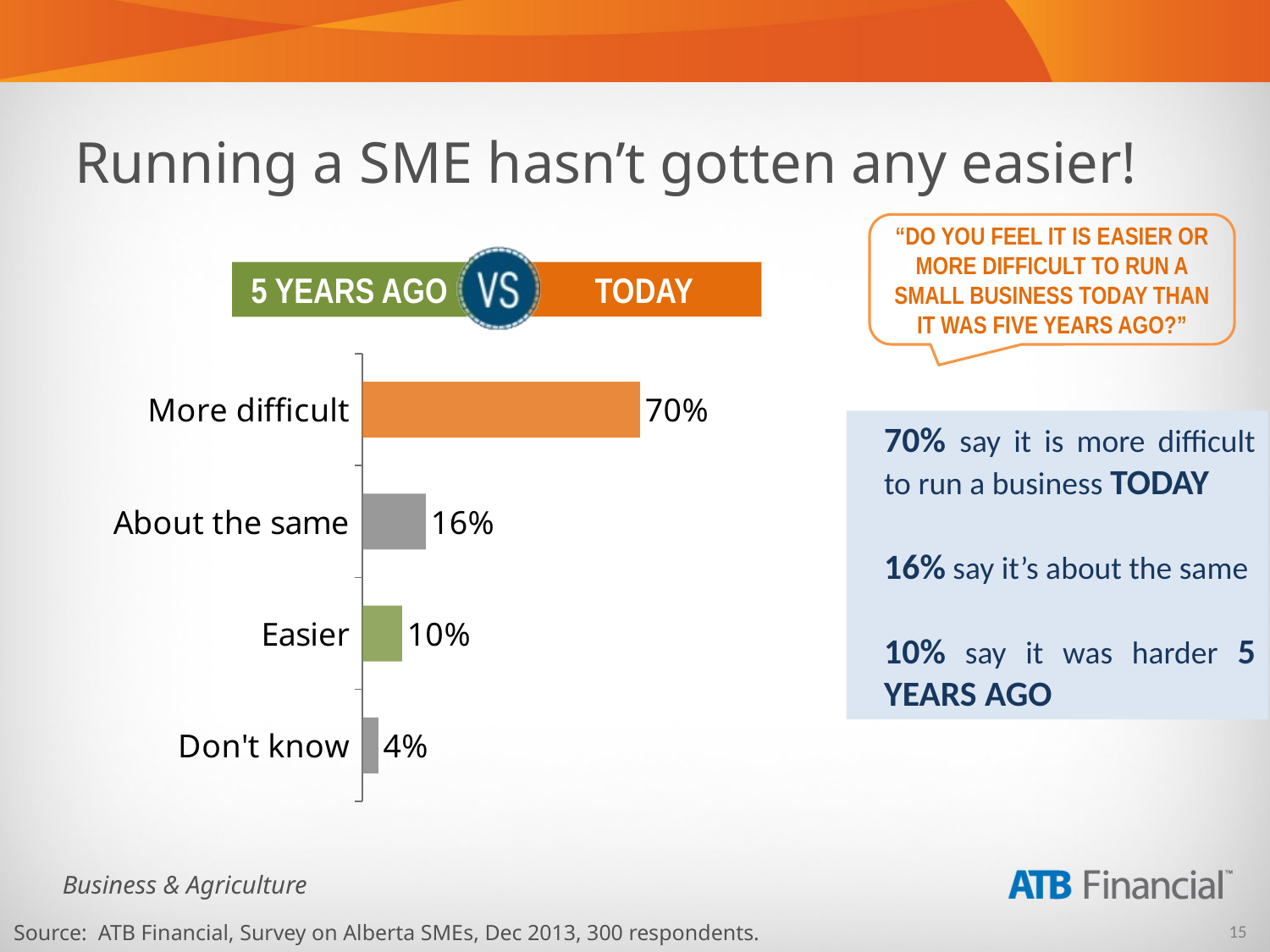
Which category has the lowest value? Don't know What percentage of respondents said running a small business is more difficult today? 70% What is the difference between the "About the same" and "Don't know" values? 12% What is the value for "About the same"? 16% Which is larger, the value for "About the same" or the value for "Easier"? About the same What is the value for "Easier"? 10% How many categories are shown in the chart? 4 Which category has the highest value? More difficult What colour is the bar for "More difficult"? Orange What kind of chart is shown on the slide? Bar chart What is the value for "Don't know"? 4% What is the difference between the "More difficult" and "Easier" values? 60%